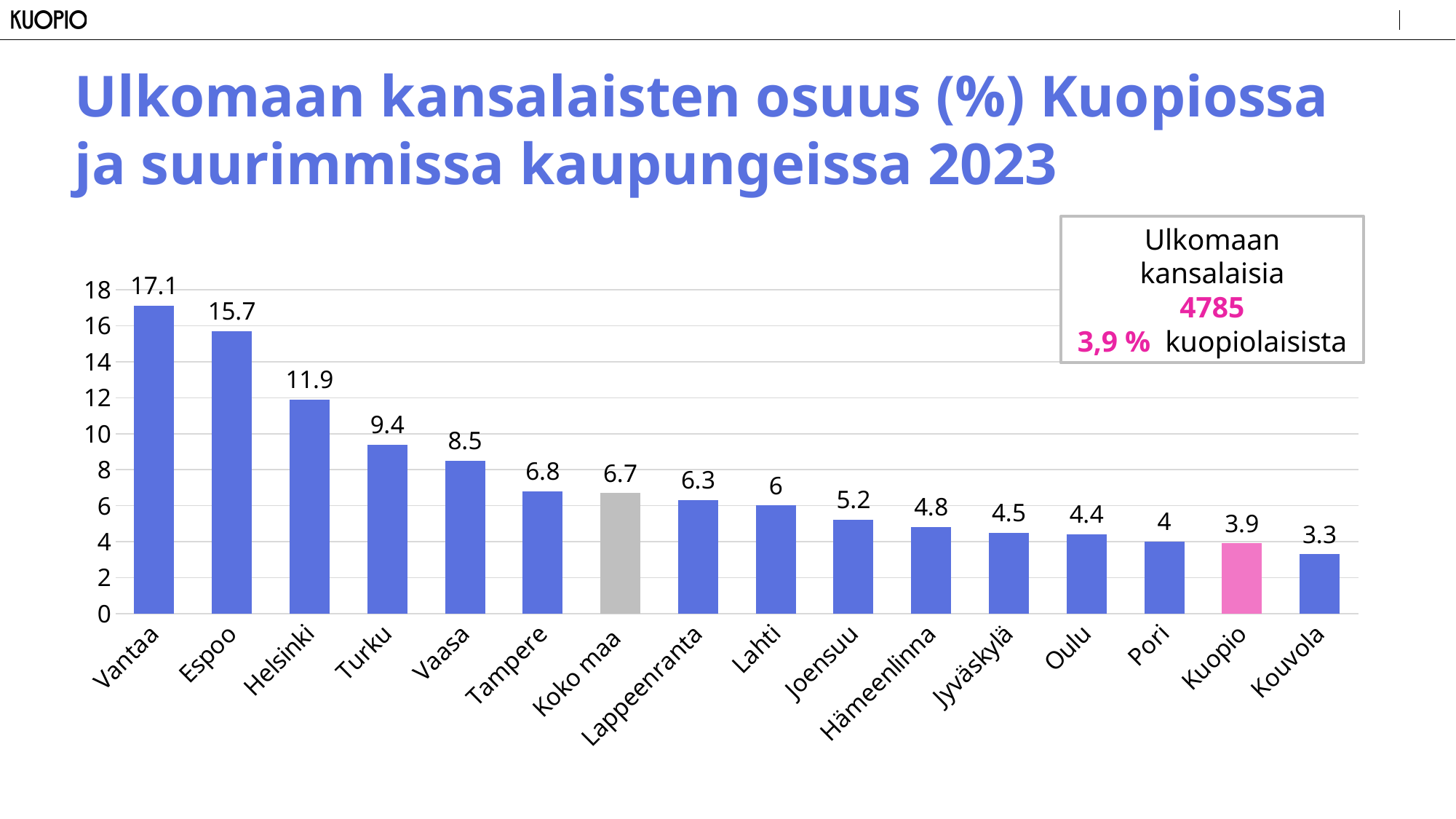
What is the difference between the values for Vantaa and Espoo? 1.4 What is the value for Kuopio? 3.9 Which bar is coloured pink? Kuopio Is the value for Lahti greater or less than 4? greater What kind of chart is shown on the slide? bar chart How many categories are shown on the x axis? 16 Which category has the lowest value? Kouvola Which is larger, the value for Turku or the value for Vaasa? Turku Which category has the highest value? Vantaa What is the difference between the values for Koko maa and Kuopio? 2.8 What is the value for Koko maa? 6.7 What is the value for Helsinki? 11.9